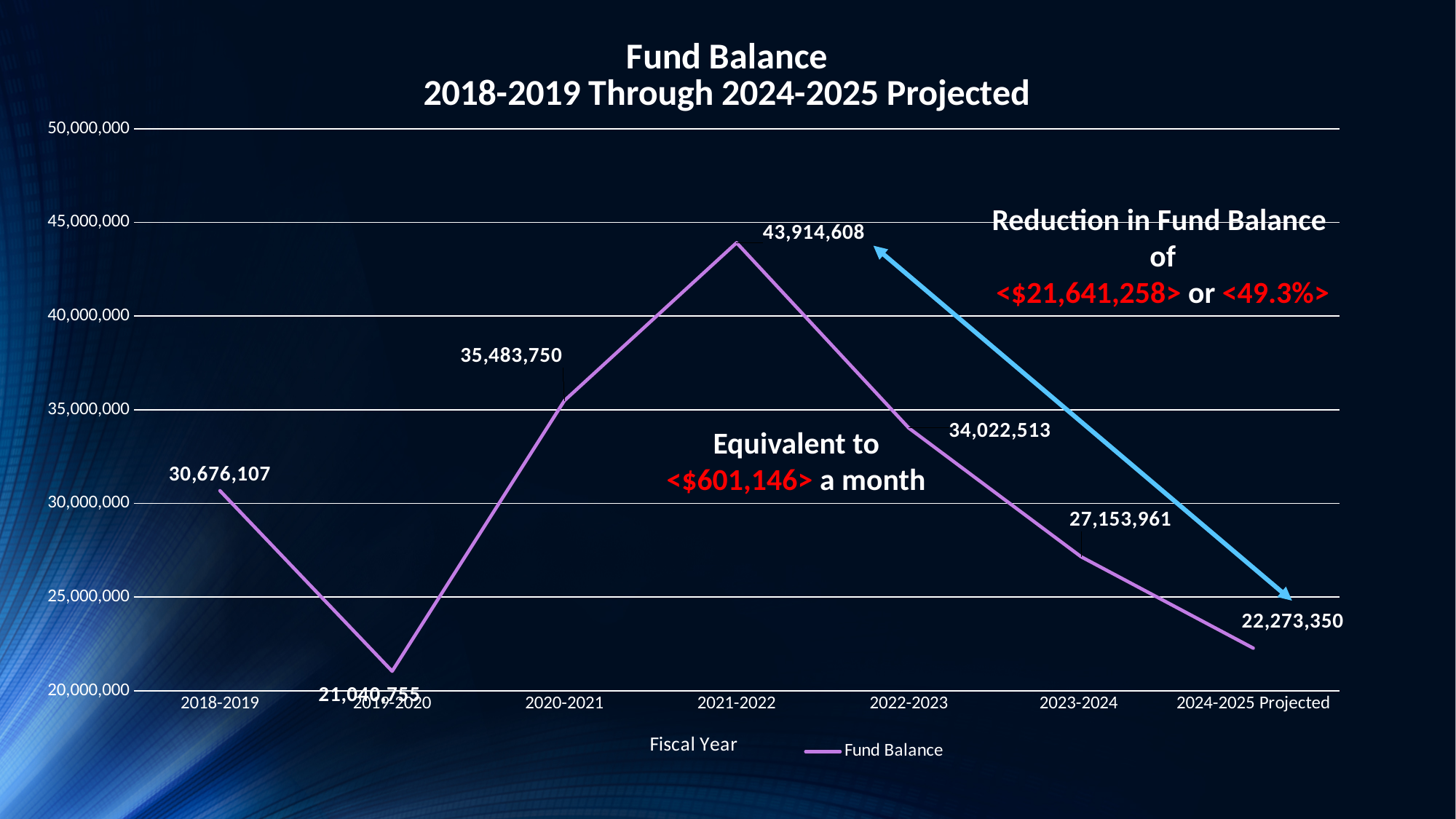
Which fiscal year has the lowest fund balance? 2019-2020 How many fiscal years are plotted on the chart? 7 Does the fund balance rise or fall from 2021-2022 to 2024-2025 Projected? Fall Which fiscal year has the highest fund balance? 2021-2022 What is the fund balance for 2021-2022? 43,914,608 Which is larger, the fund balance for 2020-2021 or for 2022-2023? 2020-2021 What is the projected fund balance for 2024-2025? 22,273,350 What is the fund balance for 2018-2019? 30,676,107 Is the fund balance for 2023-2024 greater or less than 30,000,000? less What is the fund balance for 2023-2024? 27,153,961 What is the difference between the fund balance in 2021-2022 and the projected fund balance in 2024-2025? 21,641,258 What type of chart is shown on the slide? Line chart